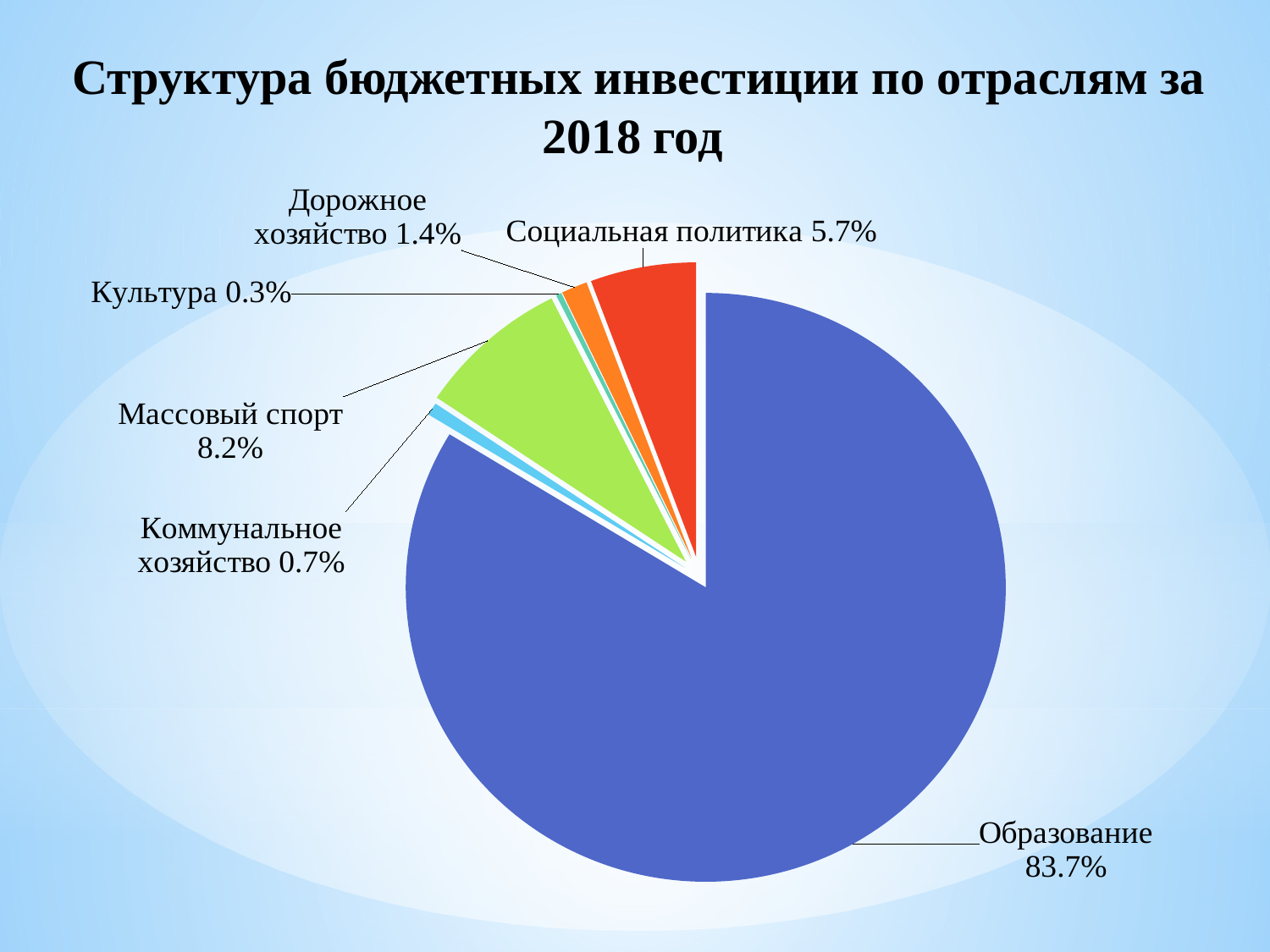
Which has a larger share: Дорожное хозяйство or Коммунальное хозяйство? Дорожное хозяйство What share of budget investments went to Образование (education)? 83.7% What is the difference in share between Массовый спорт and Социальная политика? 2.5 percentage points What share of budget investments went to Массовый спорт? 8.2% Which sector has the smallest share of budget investments? Культура What is the title of the chart? Структура бюджетных инвестиции по отраслям за 2018 год Which sector has the largest share of budget investments? Образование What share of budget investments went to Коммунальное хозяйство? 0.7% What kind of chart is shown on the slide? pie chart What share of budget investments went to Дорожное хозяйство? 1.4% What share of budget investments went to Социальная политика? 5.7% How many sectors (slices) are shown in the pie chart? 6